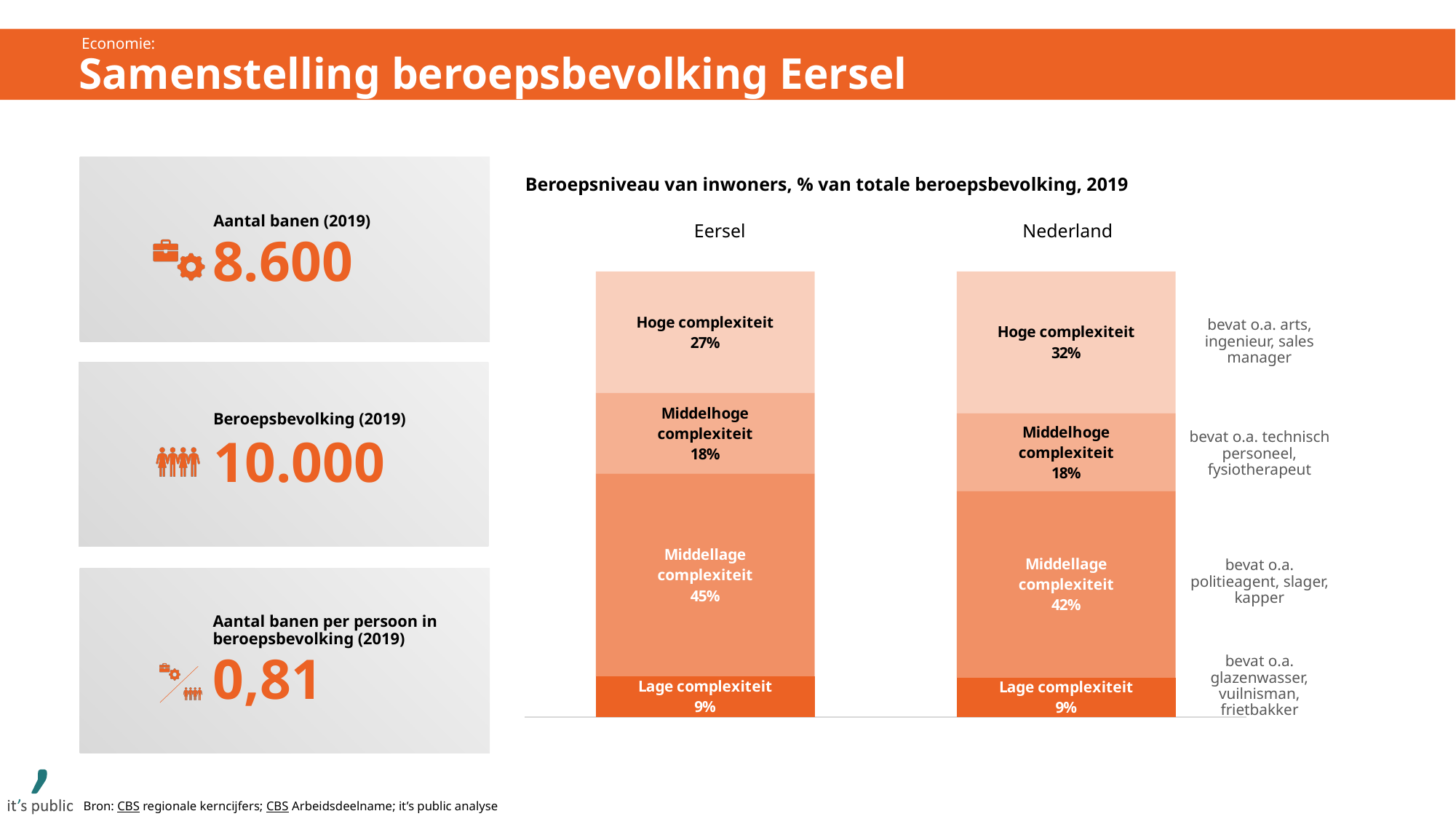
Which category is the smallest segment in the Nederland bar? Lage complexiteit What type of chart is used to show the 'Beroepsniveau van inwoners' data? Stacked bar chart What percentage of the Nederland workforce is in the 'Hoge complexiteit' category? 32% Which has a larger 'Hoge complexiteit' share, Eersel or Nederland? Nederland What is the difference between the 'Hoge complexiteit' share in Nederland and in Eersel? 5 percentage points What is the value for 'Middellage complexiteit' in the Eersel bar? 45% Which category is the largest segment in the Eersel bar? Middellage complexiteit What is the title of the chart? Beroepsniveau van inwoners, % van totale beroepsbevolking, 2019 How many bars are shown in the chart? 2 What is the difference between the 'Middellage complexiteit' share in Eersel and in Nederland? 3 percentage points What is the value for 'Lage complexiteit' in the Nederland bar? 9% What percentage of the Eersel workforce is in the 'Hoge complexiteit' category? 27%